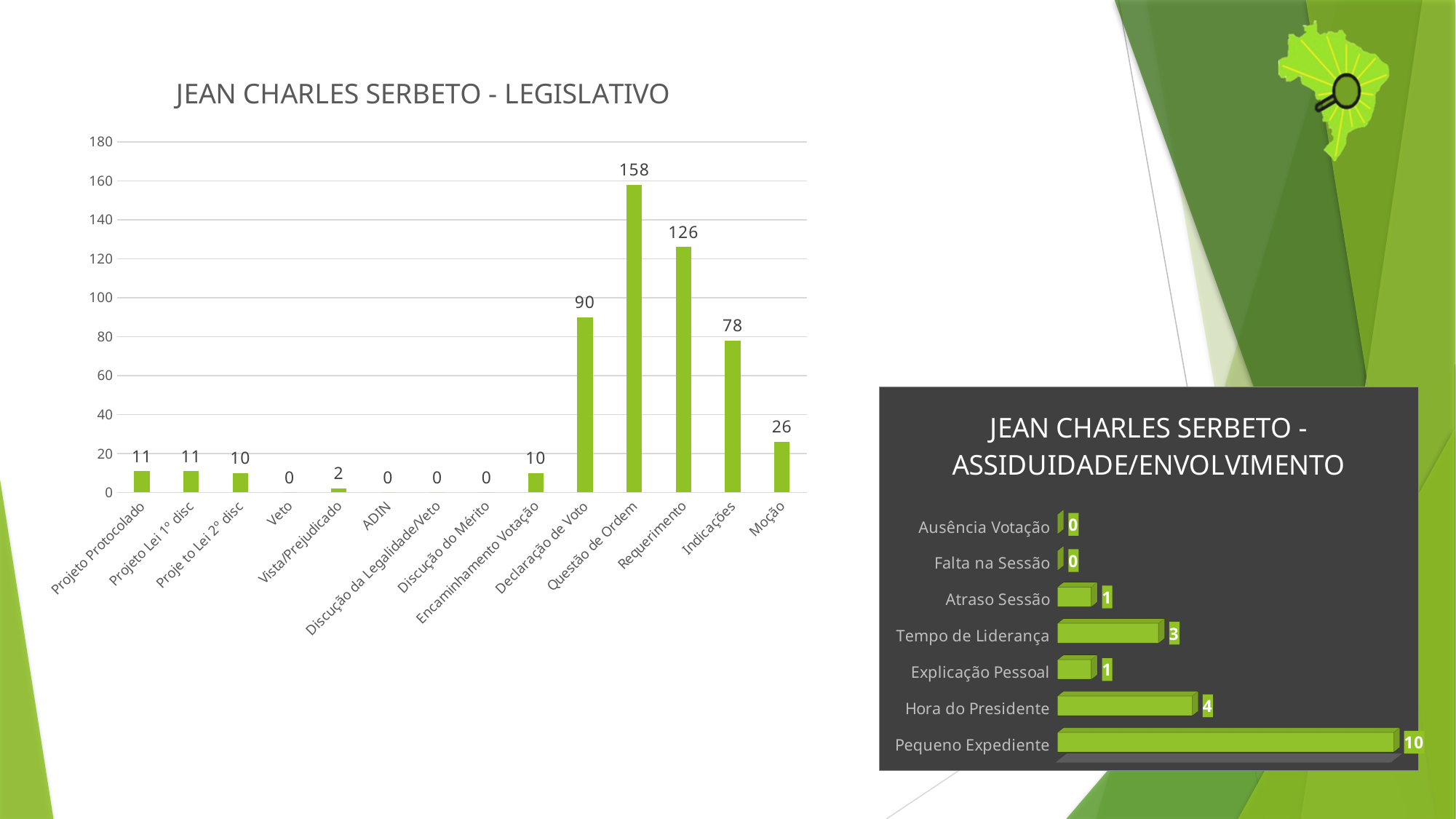
In the 'JEAN CHARLES SERBETO - ASSIDUIDADE/ENVOLVIMENTO' chart, which category has the highest value? Pequeno Expediente In the 'JEAN CHARLES SERBETO - LEGISLATIVO' chart, how many categories are shown on the x axis? 14 What kind of chart is 'JEAN CHARLES SERBETO - LEGISLATIVO'? Bar chart In the 'JEAN CHARLES SERBETO - LEGISLATIVO' chart, what is the value for Questão de Ordem? 158 In the 'JEAN CHARLES SERBETO - LEGISLATIVO' chart, what is the value for Requerimento? 126 In the 'JEAN CHARLES SERBETO - ASSIDUIDADE/ENVOLVIMENTO' chart, how many categories are shown? 7 In the 'JEAN CHARLES SERBETO - ASSIDUIDADE/ENVOLVIMENTO' chart, what is the difference between Hora do Presidente and Tempo de Liderança? 1 In the 'JEAN CHARLES SERBETO - LEGISLATIVO' chart, what is the difference between Questão de Ordem and Requerimento? 32 In the 'JEAN CHARLES SERBETO - LEGISLATIVO' chart, which is larger, Declaração de Voto or Indicações? Declaração de Voto In the 'JEAN CHARLES SERBETO - LEGISLATIVO' chart, what is the value for Moção? 26 In the 'JEAN CHARLES SERBETO - ASSIDUIDADE/ENVOLVIMENTO' chart, what is the value for Pequeno Expediente? 10 In the 'JEAN CHARLES SERBETO - LEGISLATIVO' chart, which category has the highest value? Questão de Ordem